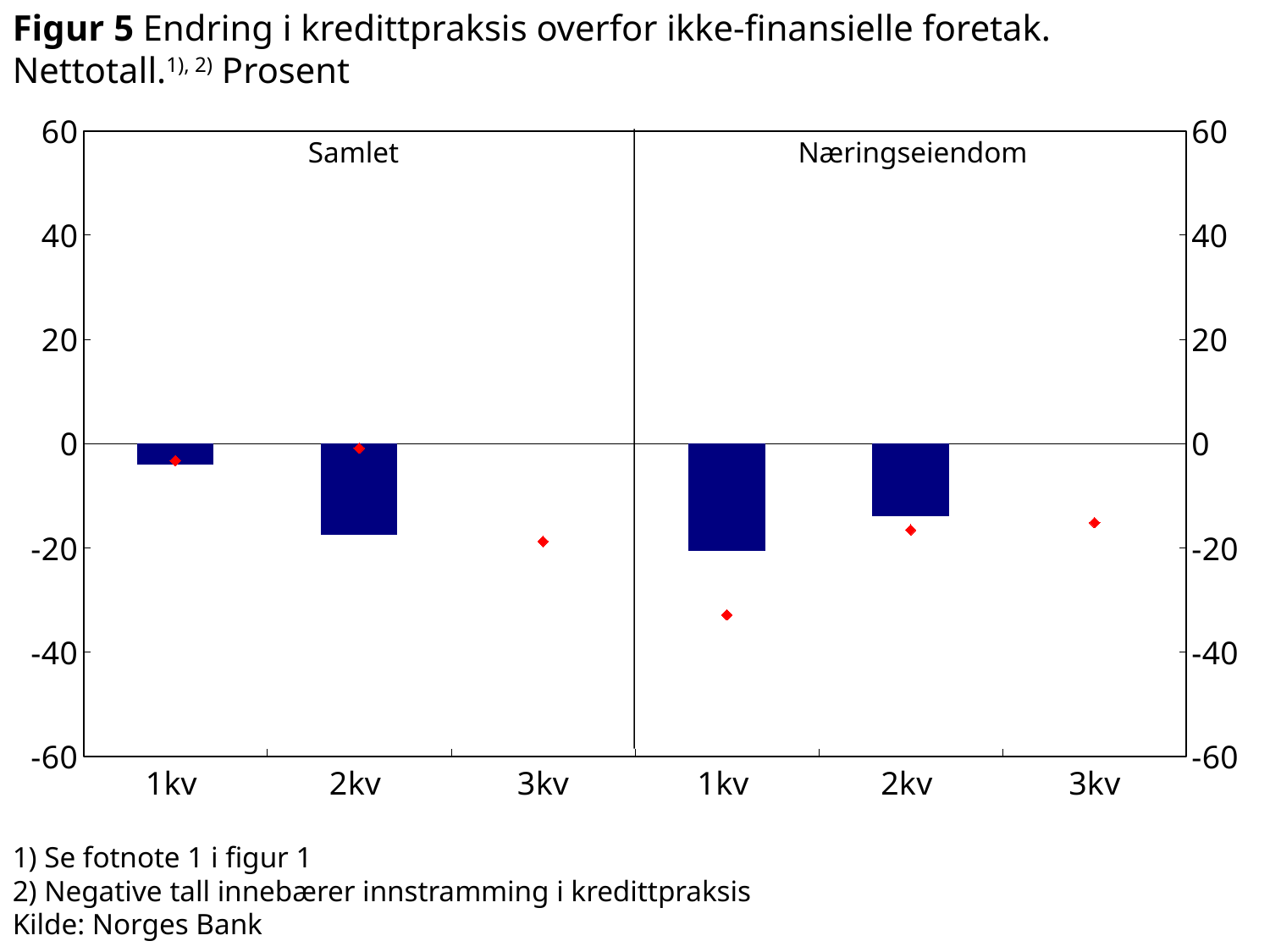
In the Samlet panel, which bar is larger (less negative): 1kv or 2kv? 1kv In the Næringseiendom panel, which quarter has the lowest (most negative) bar? 1kv What are the two panel labels shown at the top of the chart? Samlet and Næringseiendom Which red marker is the lowest across the whole chart? 1kv in the Næringseiendom panel Is the red marker for 1kv in the Næringseiendom panel greater or less than -20? less Is the bar for 1kv in the Næringseiendom panel greater or less than -10? less What kind of chart is shown in Figur 5? bar chart with red diamond markers (combination bar and line chart) How many quarter categories are shown along the x axis in total across both panels? 6 Is the bar for 1kv in the Samlet panel greater or less than -20? greater In the Samlet panel, which quarter has the lowest (most negative) bar? 2kv In the Næringseiendom panel, which bar is larger (less negative): 1kv or 2kv? 2kv